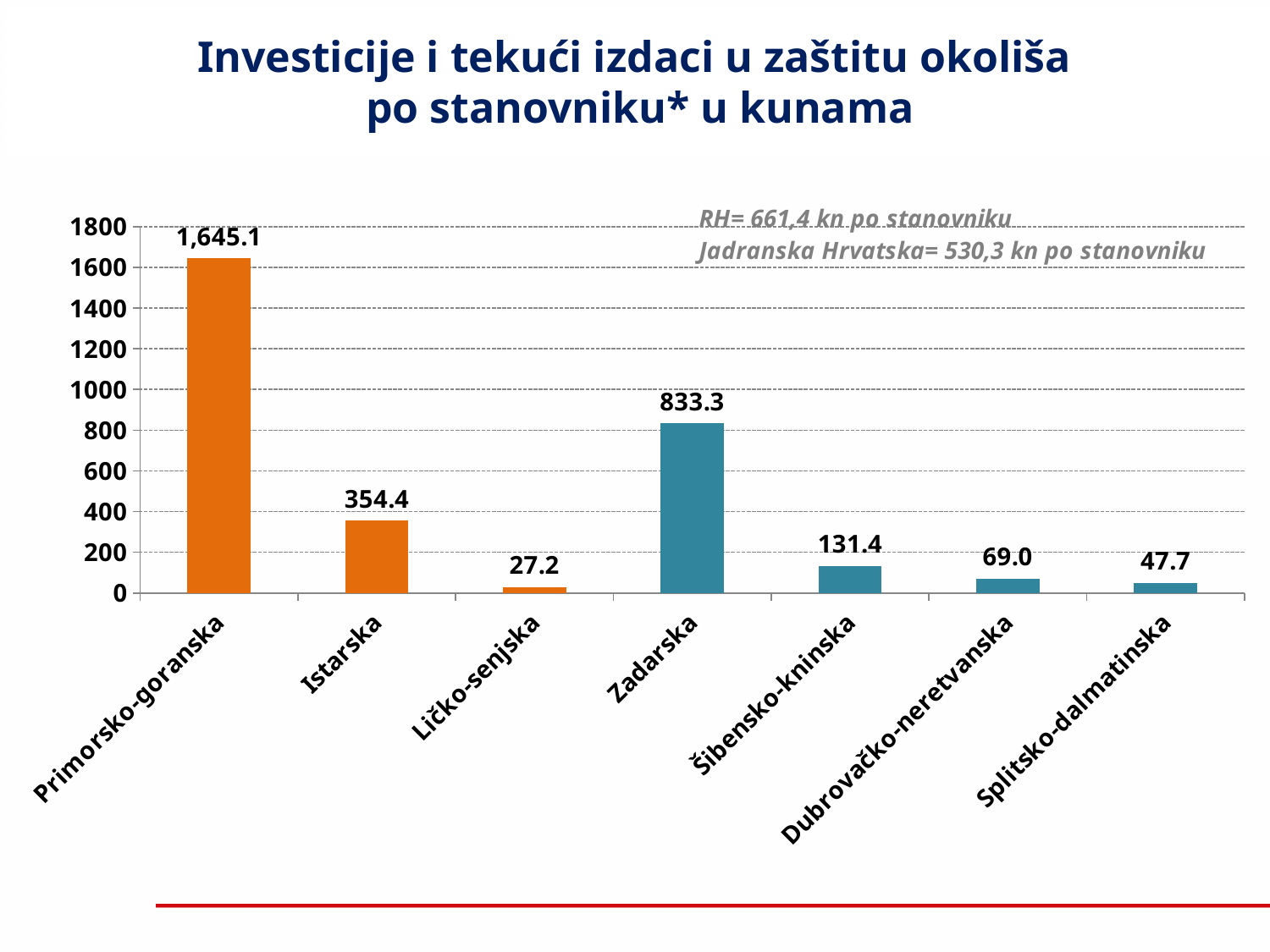
What is the value for Primorsko-goranska? 1,645.1 What is the value for Ličko-senjska? 27.2 What kind of chart is shown on the slide? bar chart What is the value for Dubrovačko-neretvanska? 69.0 Which category has the lowest value? Ličko-senjska Which is larger, the value for Splitsko-dalmatinska or the value for Dubrovačko-neretvanska? Dubrovačko-neretvanska Which category has the highest value? Primorsko-goranska What is the value for Zadarska? 833.3 Is the value for Istarska greater or less than 400? less According to the annotation on the chart, what is the value for Jadranska Hrvatska? 530,3 kn po stanovniku What is the difference between the values for Istarska and Šibensko-kninska? 223.0 How many categories are shown on the x axis? 7